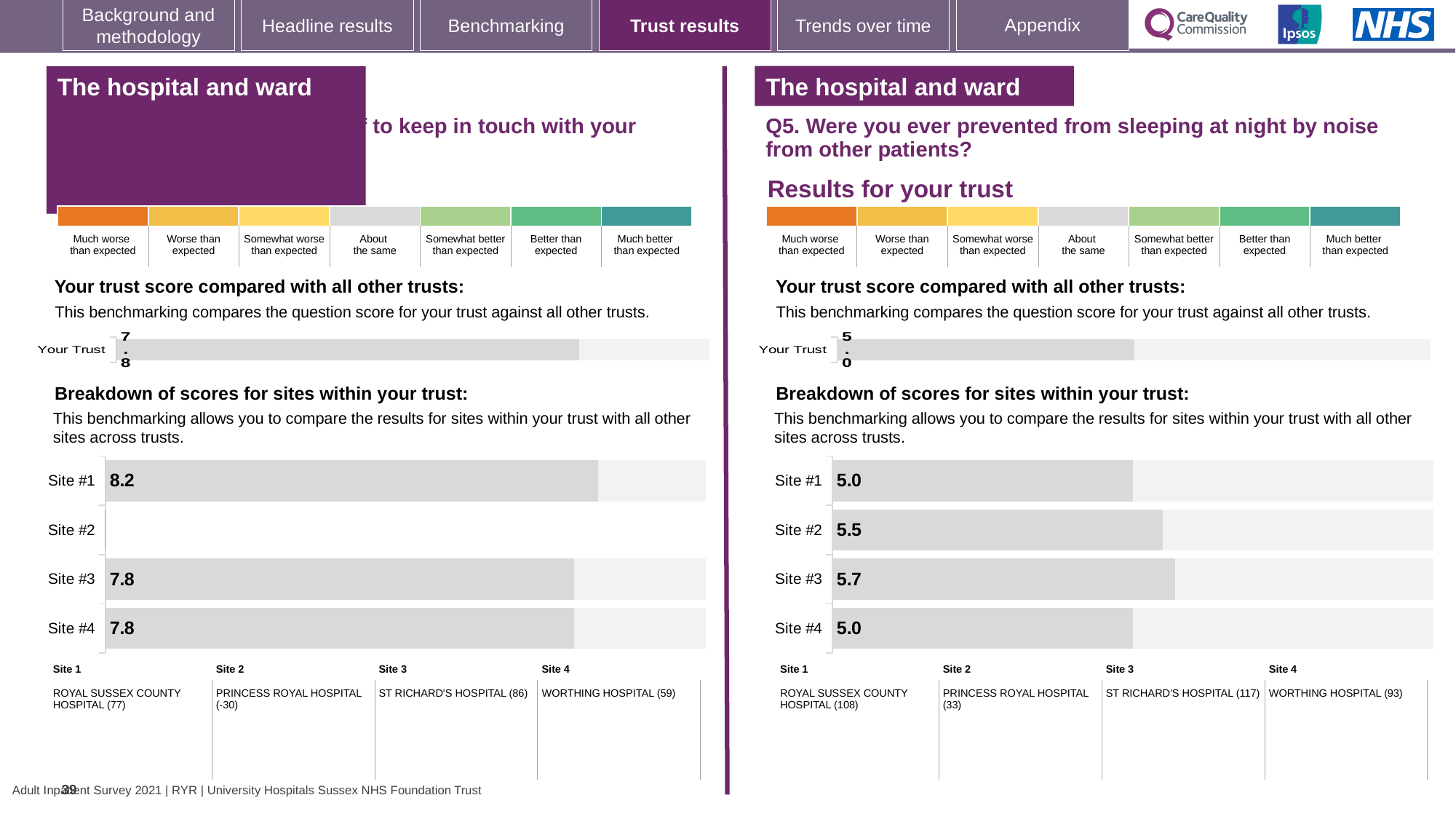
On the right-hand chart for Q5, which is larger, the score for Site #2 or the score for Site #4? Site #2 On the left-hand chart (breakdown of scores for sites within your trust), which site has the highest score? Site #1 On the right-hand chart for Q5, what is the score for Site #2? 5.5 How many site categories are listed on the right-hand site breakdown chart for Q5? 4 On the right-hand chart for Q5, what is the 'Your Trust' score shown in the trust benchmarking bar? 5.0 What kind of chart is used for the breakdown of scores for sites within your trust on the right-hand side? Bar chart On the right-hand chart for Q5 (prevented from sleeping at night by noise from other patients), what is the score for Site #3? 5.7 On the left-hand chart, what is the 'Your Trust' score shown in the trust benchmarking bar? 7.8 On the right-hand chart for Q5, which site has the highest score? Site #3 On the right-hand chart for Q5, what is the difference between the scores for Site #3 and Site #1? 0.7 On the left-hand chart (breakdown of scores for sites within your trust), what is the difference between the scores for Site #1 and Site #3? 0.4 On the left-hand chart (breakdown of scores for sites within your trust), what is the score for Site #1? 8.2